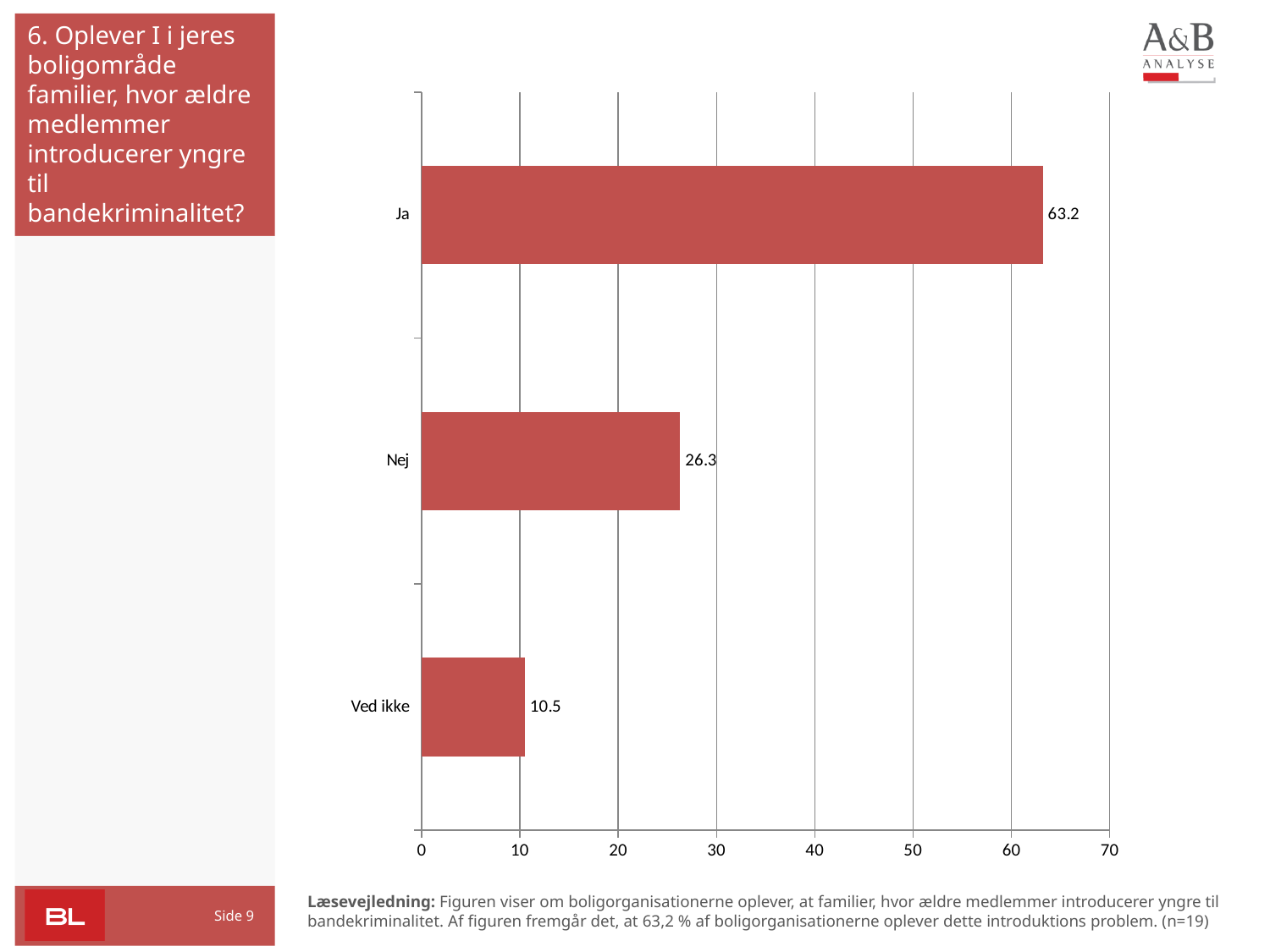
What is the maximum value shown on the horizontal axis? 70 What is the difference between the values for Ja and Nej? 36.9 Which category has the highest value? Ja What is the difference between the values for Nej and Ved ikke? 15.8 Which is larger, the value for Nej or the value for Ved ikke? Nej What kind of chart is shown on the slide? bar chart What is the value for Ja? 63.2 How many categories are shown in the chart? 3 What is the value for Nej? 26.3 Which category has the lowest value? Ved ikke Is the value for Ja greater or less than 60? greater What is the value for Ved ikke? 10.5